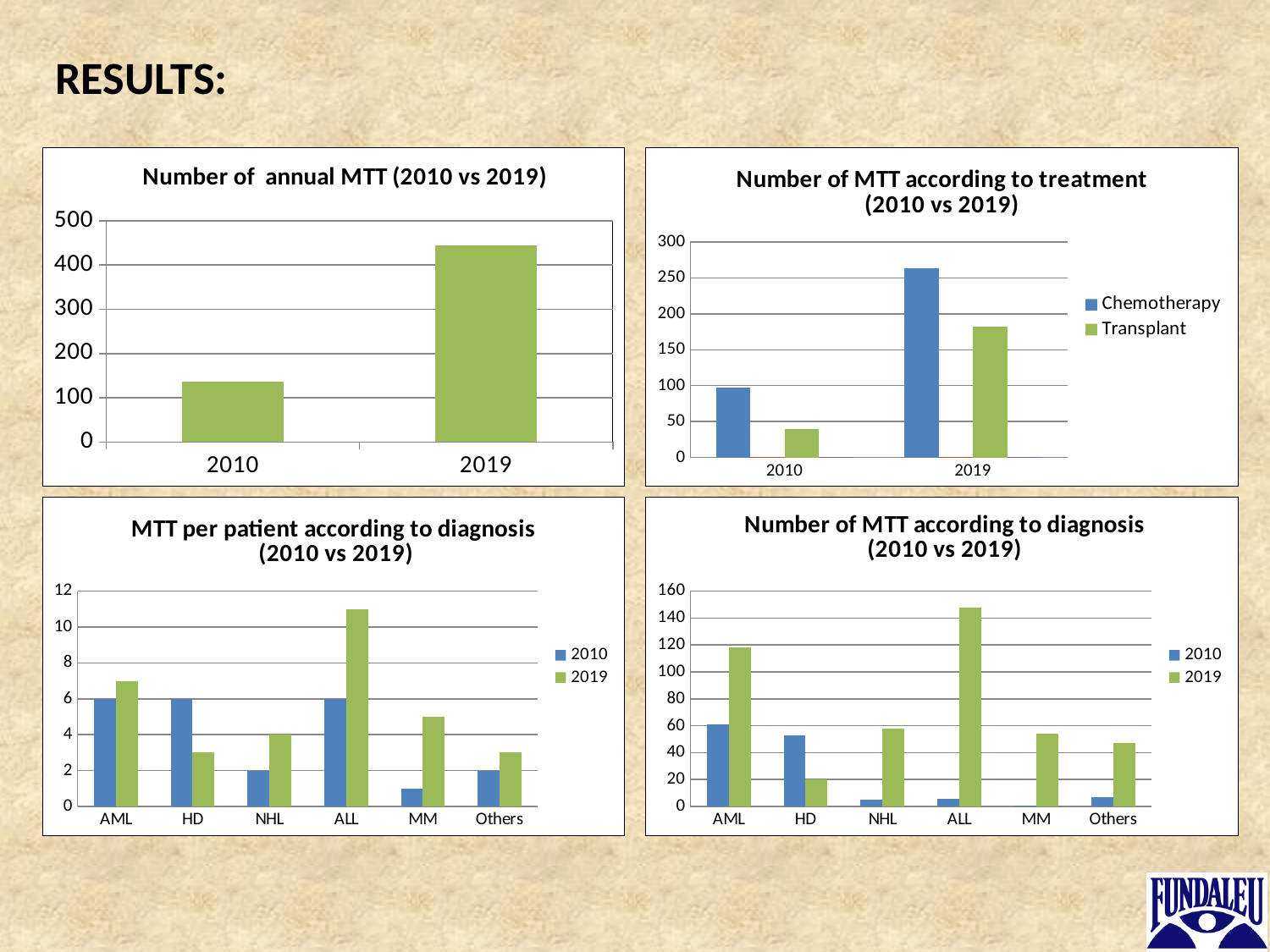
In the 'Number of MTT according to diagnosis (2010 vs 2019)' chart, what is the 2019 value for HD? 20 What kind of chart is 'Number of MTT according to treatment (2010 vs 2019)'? bar chart In the 'MTT per patient according to diagnosis (2010 vs 2019)' chart, what is the 2010 value for AML? 6 In the 'Number of MTT according to treatment (2010 vs 2019)' chart, which treatment has the larger value in 2010, Chemotherapy or Transplant? Chemotherapy In the 'Number of MTT according to diagnosis (2010 vs 2019)' chart, is the 2019 value for ALL greater or less than 140? greater In the 'Number of annual MTT (2010 vs 2019)' chart, is the value for 2019 greater or less than 400? greater How many series does the legend list in the 'Number of MTT according to treatment (2010 vs 2019)' chart? 2 In the 'MTT per patient according to diagnosis (2010 vs 2019)' chart, which diagnosis has the highest 2019 value? ALL How many diagnosis categories are shown on the x axis of the 'MTT per patient according to diagnosis (2010 vs 2019)' chart? 6 In the 'Number of MTT according to treatment (2010 vs 2019)' chart, is the Chemotherapy value for 2019 greater or less than 250? greater In the 'Number of annual MTT (2010 vs 2019)' chart, which year has the higher number of MTT? 2019